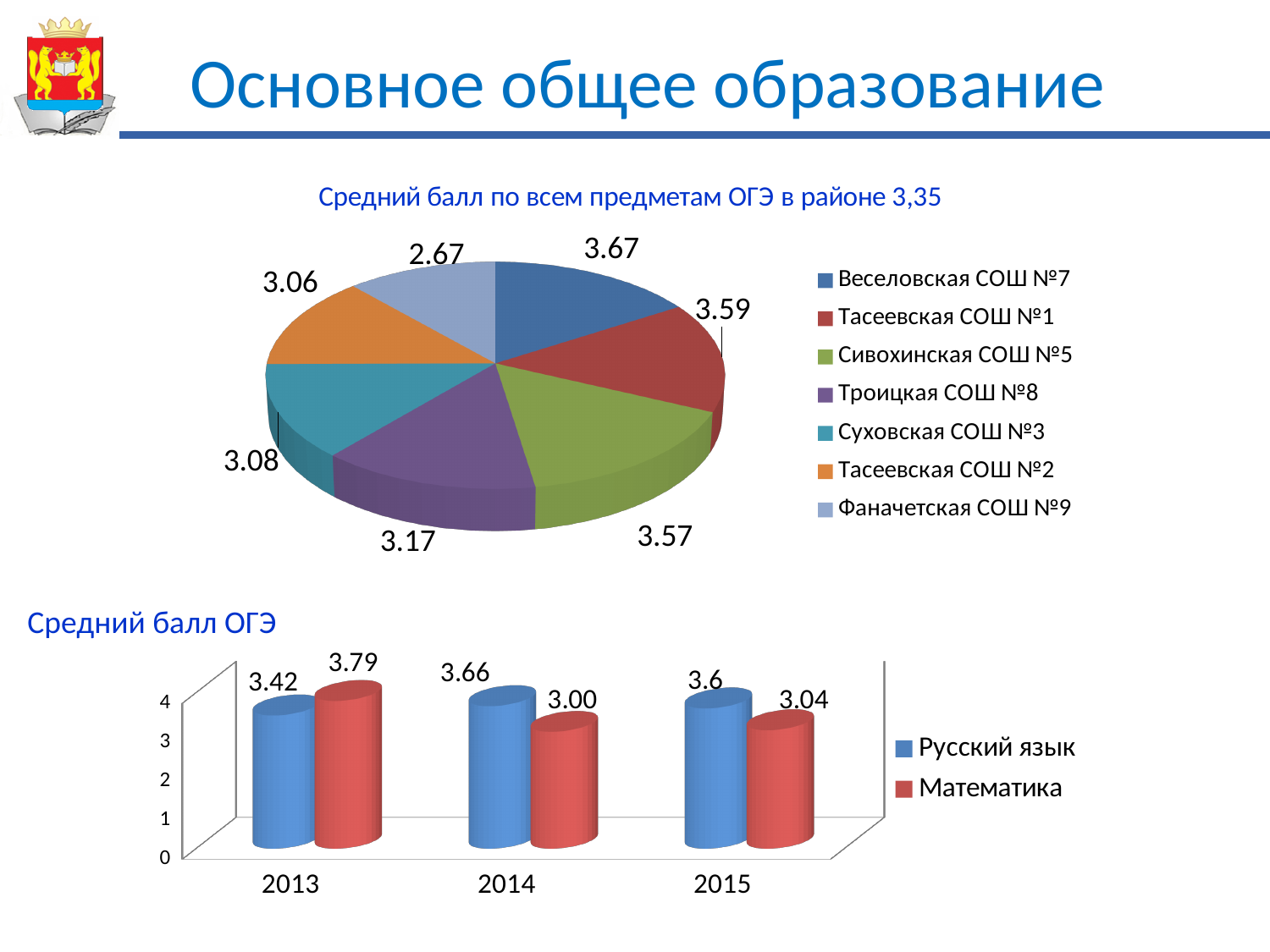
In the bar chart 'Средний балл ОГЭ', how many series does the legend list? 2 In the bar chart 'Средний балл ОГЭ', which is larger in 2014: Русский язык or Математика? Русский язык What type of chart is the lower chart 'Средний балл ОГЭ'? Bar chart In the bar chart 'Средний балл ОГЭ', what is the difference between Русский язык and Математика in 2014? 0.66 In the pie chart, which school has the highest value? Веселовская СОШ №7 In the pie chart, what is the value for Веселовская СОШ №7? 3.67 In the pie chart, what is the value for Фаначетская СОШ №9? 2.67 In the bar chart 'Средний балл ОГЭ', what is the value for Математика in 2013? 3.79 In the pie chart, how many schools are listed in the legend? 7 In the pie chart, what is the difference between the values for Веселовская СОШ №7 and Фаначетская СОШ №9? 1.00 In the pie chart, which school has the lowest value? Фаначетская СОШ №9 In the bar chart 'Средний балл ОГЭ', what is the value for Русский язык in 2015? 3.6